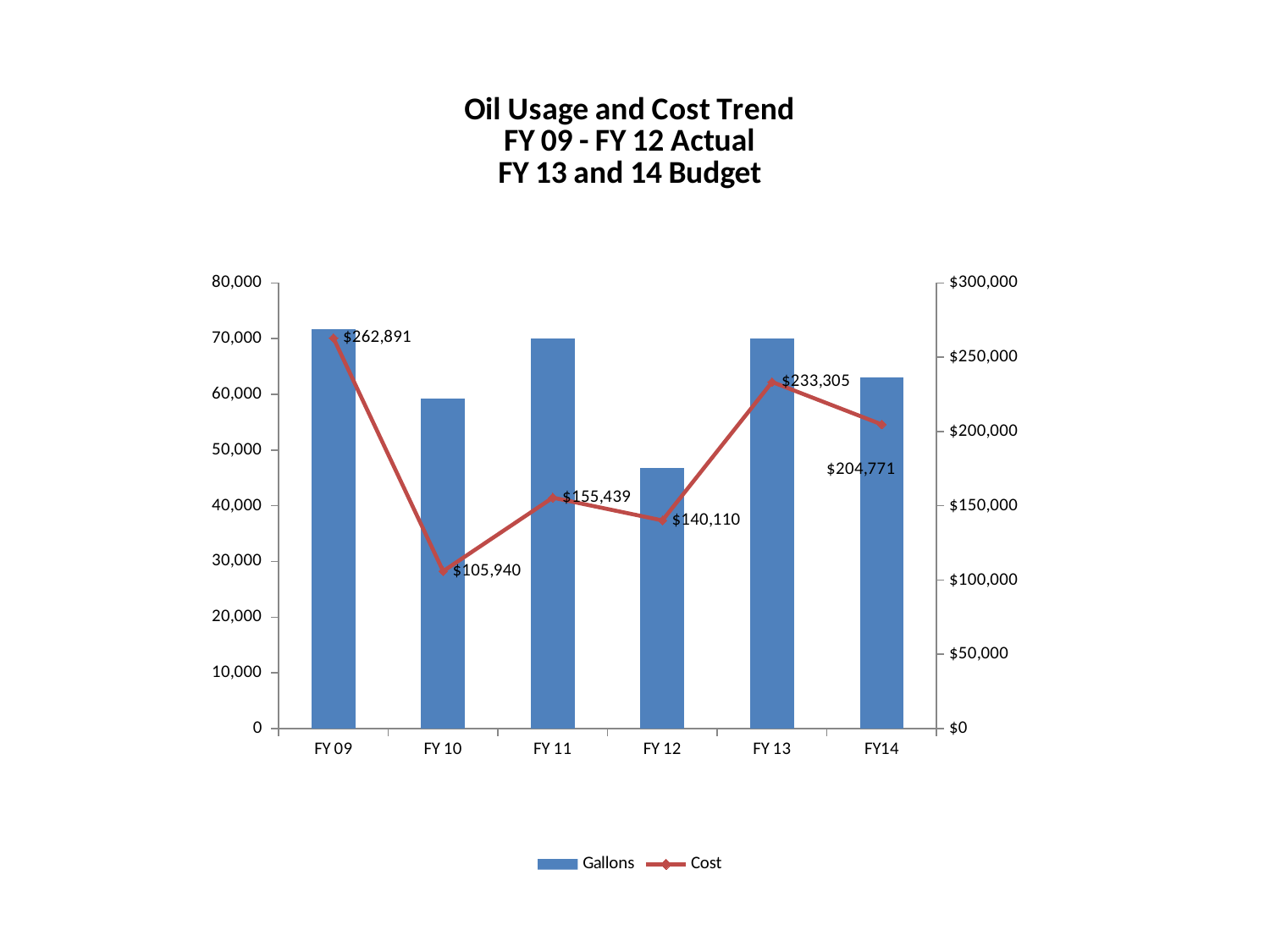
What is the Cost value for FY 09? $262,891 Which has the larger Cost, FY 11 or FY 12? FY 11 Is the Gallons value for FY 12 greater or less than 50,000? less What is the difference in Cost between FY 09 and FY 10? $156,951 Which fiscal year has the lowest Gallons value? FY 12 What is the Cost value for FY 12? $140,110 What is the Cost value for FY14? $204,771 Which fiscal year has the highest Cost? FY 09 How many series does the legend list? 2 What kind of chart is shown on the slide? Combination bar and line chart Which fiscal year has the lowest Cost? FY 10 How many fiscal years are shown on the x axis? 6